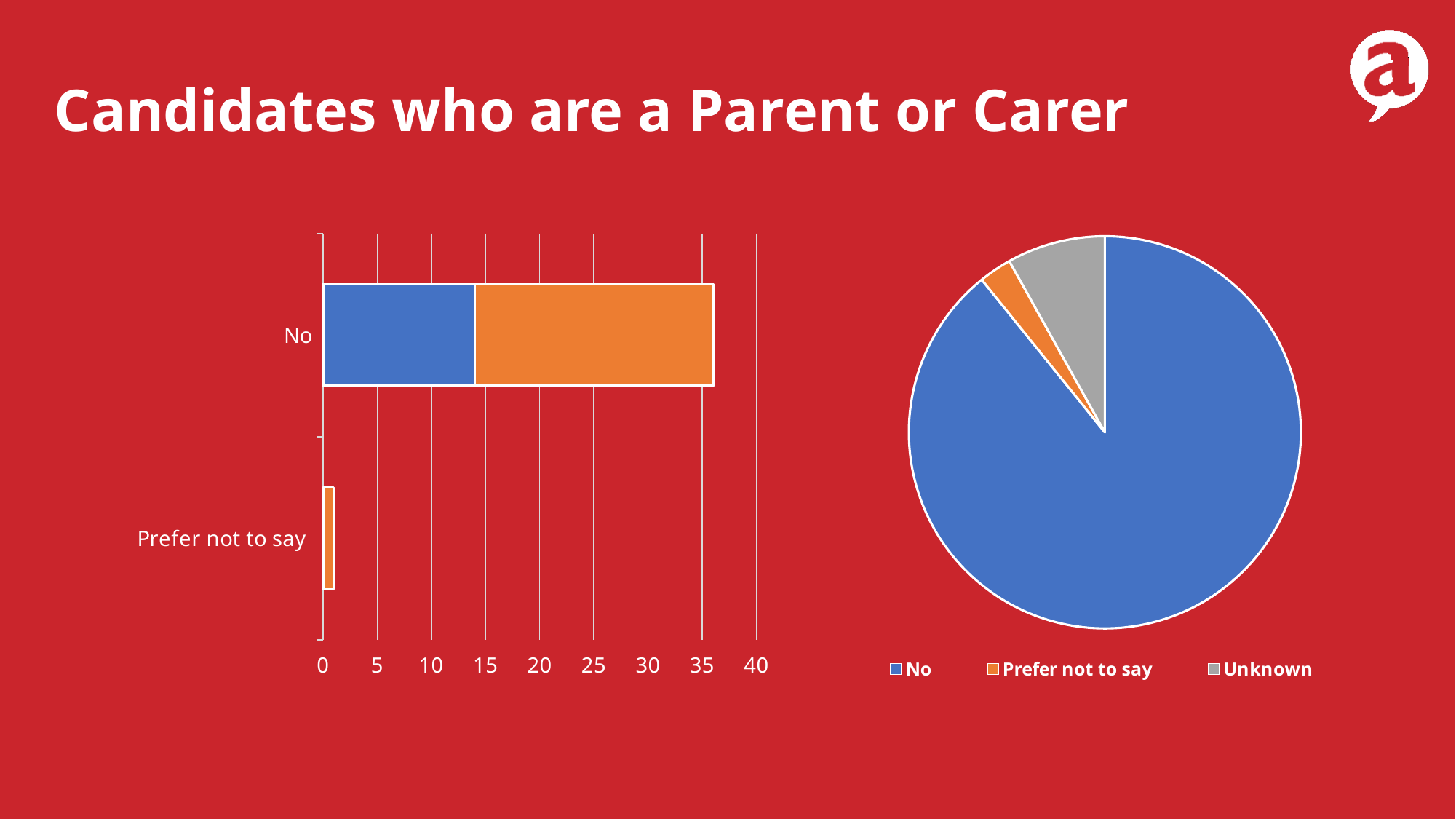
In the bar chart on the left, is the value for Prefer not to say greater or less than 5? less In the bar chart on the left, which category has the longer bar, No or Prefer not to say? No In the pie chart on the right, which category has the smallest slice? Prefer not to say What kind of chart is the chart on the left of the slide? bar chart What is the title of the slide? Candidates who are a Parent or Carer What kind of chart is the chart on the right of the slide? pie chart In the bar chart on the left, how many categories are shown on the vertical axis? 2 In the pie chart on the right, what colour is the slice for No? blue In the bar chart on the left, is the total length of the bar for No greater or less than 30? greater In the pie chart on the right, which category has the largest slice? No In the pie chart on the right, which slice is larger, Unknown or Prefer not to say? Unknown In the pie chart on the right, how many entries does the legend list? 3